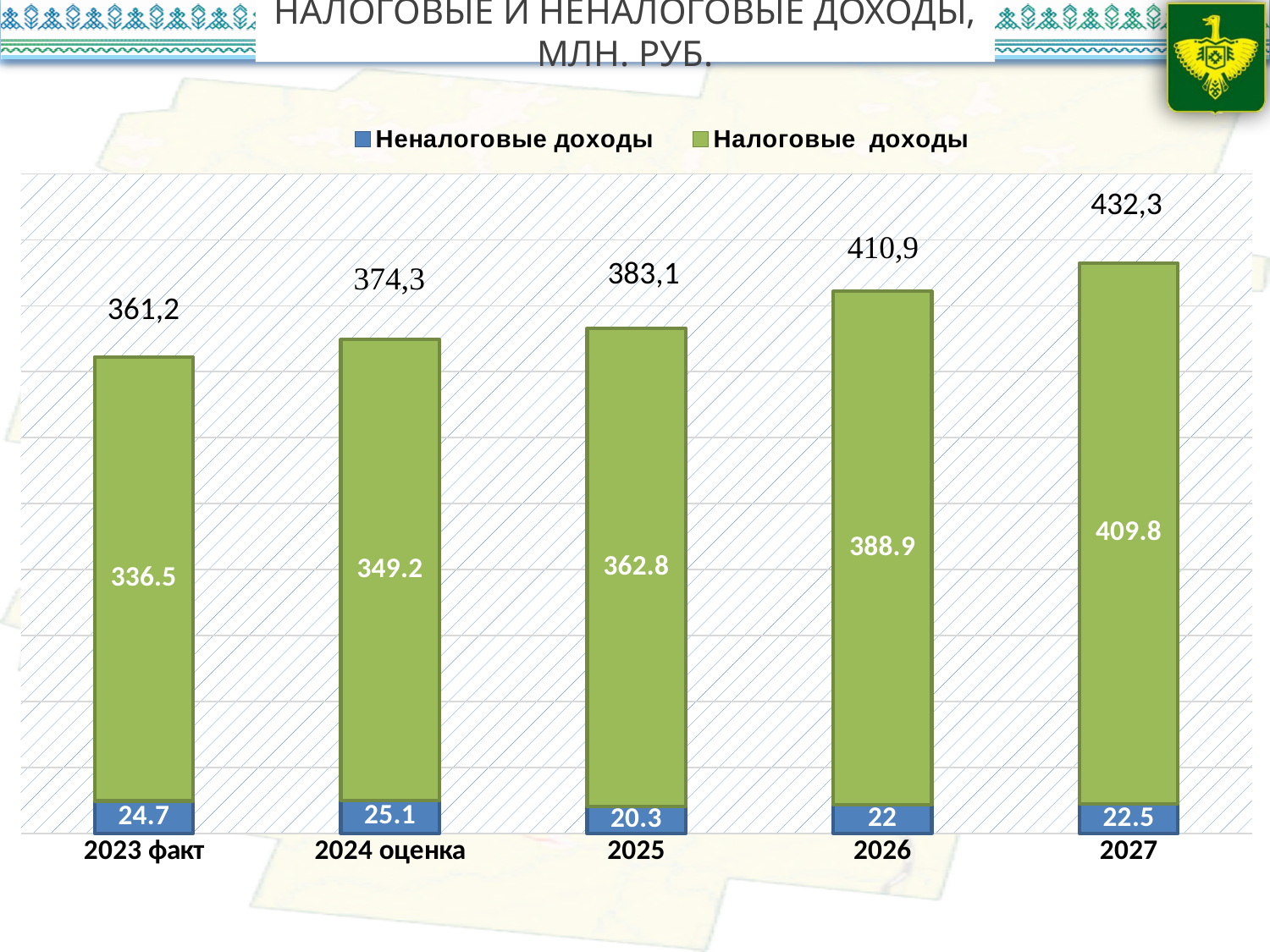
What is the total shown above the stacked bar for 2026? 410,9 What is the value of Налоговые доходы for 2025? 362.8 How many categories are shown on the x axis? 5 How many series does the legend list? 2 What is the value of Неналоговые доходы for 2023 факт? 24.7 What is the value of Неналоговые доходы for 2026? 22 What is the difference between Налоговые доходы in 2027 and in 2023 факт? 73.3 Which is larger: Неналоговые доходы in 2024 оценка or in 2027? 2024 оценка What is the total shown above the stacked bar for 2024 оценка? 374,3 Which category has the highest value for Налоговые доходы? 2027 What is the value of Налоговые доходы for 2027? 409.8 Which category has the lowest value for Неналоговые доходы? 2025